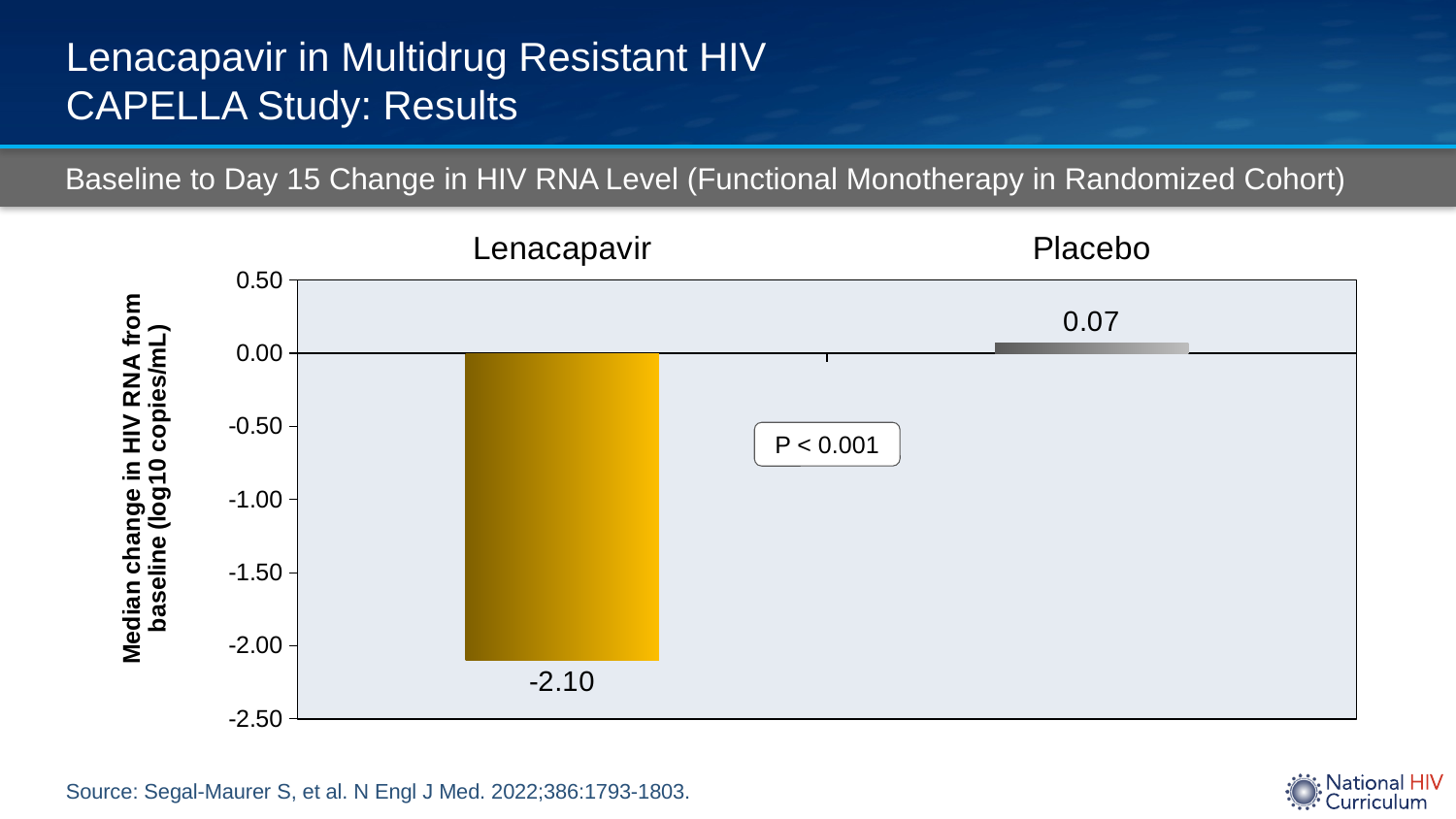
How many groups are plotted in the chart? 2 What kind of chart is shown on the slide? Bar chart What is the difference between the Placebo value and the Lenacapavir value? 2.17 Is the value for Lenacapavir greater or less than -2.00? less What is the median change in HIV RNA from baseline for Lenacapavir? -2.10 What P value is shown on the chart? P < 0.001 What is the median change in HIV RNA from baseline for Placebo? 0.07 Is the value for Placebo greater or less than 0.00? greater Which group has the highest median change in HIV RNA from baseline? Placebo Which group has the lowest median change in HIV RNA from baseline? Lenacapavir What is the label of the y axis? Median change in HIV RNA from baseline (log10 copies/mL) Which value is larger, Lenacapavir or Placebo? Placebo